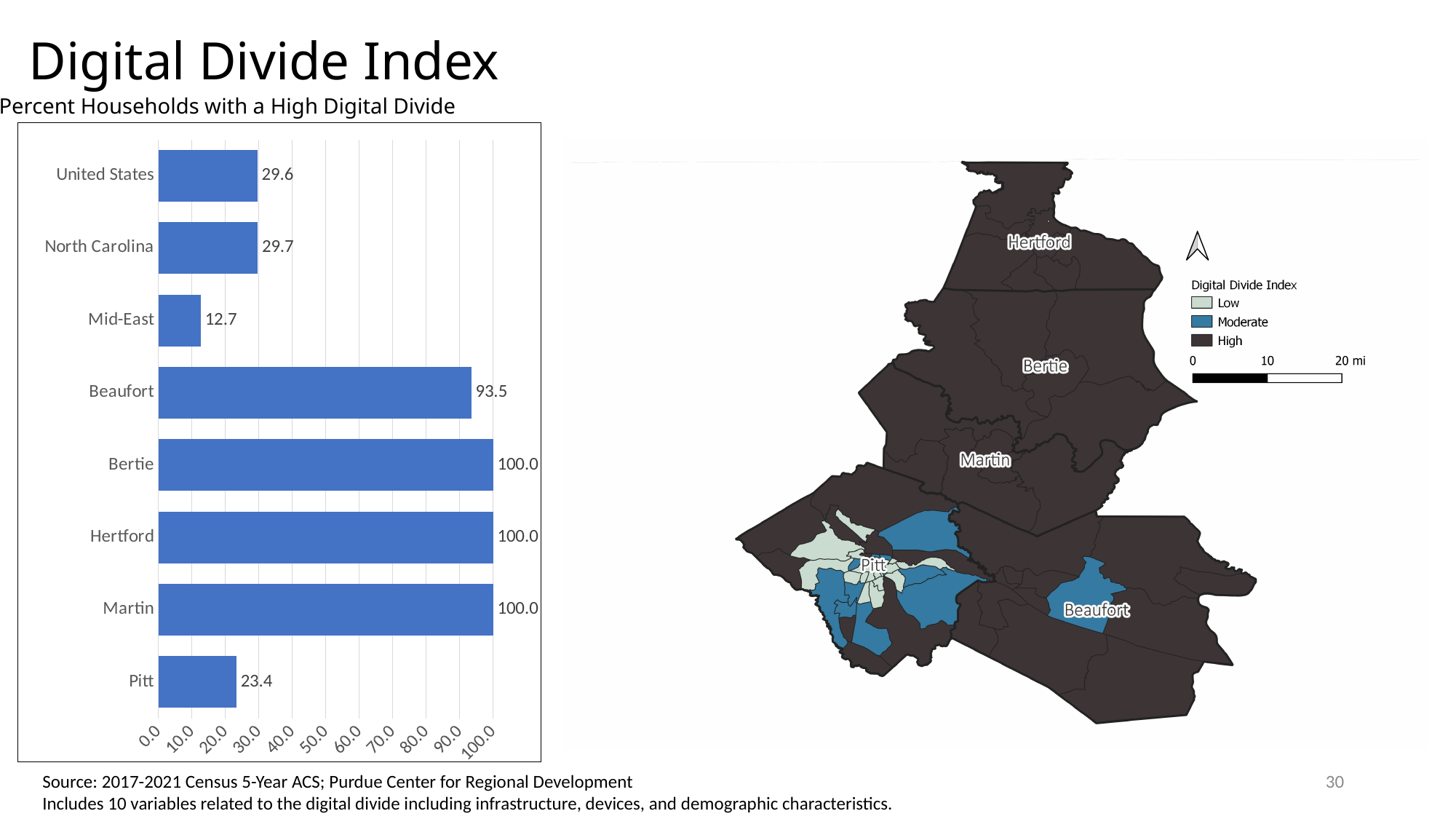
What is the difference between the values for Bertie and Beaufort in the bar chart? 6.5 What is the value for Beaufort in the bar chart? 93.5 What is the value for North Carolina in the bar chart? 29.7 What is the difference between the values for Beaufort and Pitt in the bar chart? 70.1 What is the subtitle above the bar chart? Percent Households with a High Digital Divide What is the value for Mid-East in the bar chart? 12.7 In the bar chart, which is larger, the value for Beaufort or the value for Pitt? Beaufort Which category has the lowest value in the bar chart? Mid-East Is the value for Beaufort in the bar chart greater or less than 90.0? greater How many categories are shown in the bar chart? 8 What kind of chart is shown on the left of the slide? bar chart What is the value for Pitt in the bar chart? 23.4